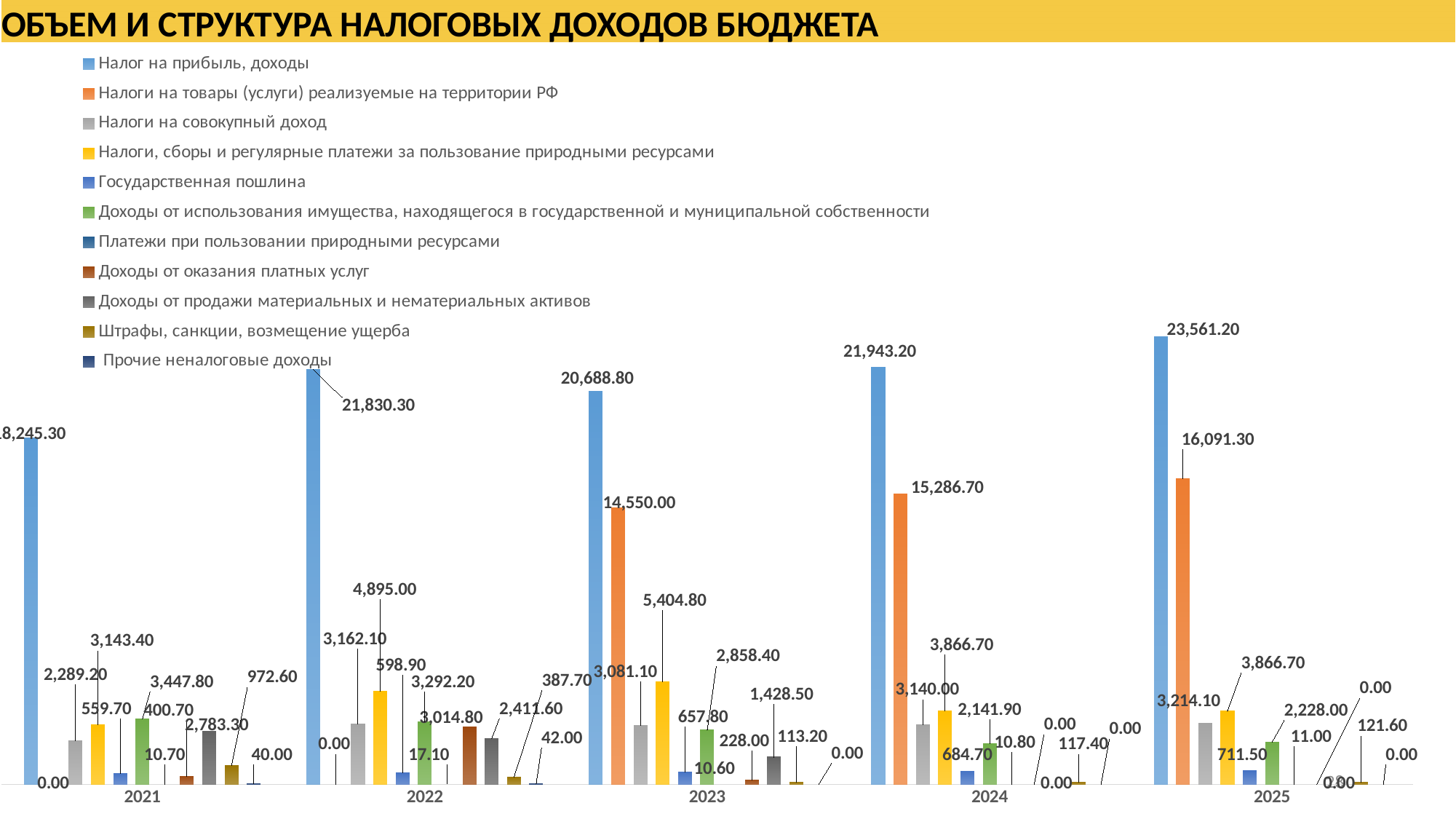
In which year is 'Налог на прибыль, доходы' the highest? 2025 What is the value of 'Налоги на товары (услуги) реализуемые на территории РФ' for 2025? 16,091.30 Do the values of 'Налоги на товары (услуги) реализуемые на территории РФ' rise or fall from 2023 to 2025? rise How many years (categories) are shown on the x axis? 5 What is the value of 'Налоги на товары (услуги) реализуемые на территории РФ' for 2023? 14,550.00 What is the value of 'Налог на прибыль, доходы' for 2025? 23,561.20 What kind of chart is shown on the slide? bar chart How many series does the legend list? 11 What is the value of 'Налог на прибыль, доходы' for 2023? 20,688.80 Which year has the larger value for 'Налог на прибыль, доходы': 2022 or 2023? 2022 What is the difference between 'Налог на прибыль, доходы' in 2025 and in 2024? 1,618.00 What is the title of the chart on the slide? ОБЪЕМ И СТРУКТУРА НАЛОГОВЫХ ДОХОДОВ БЮДЖЕТА